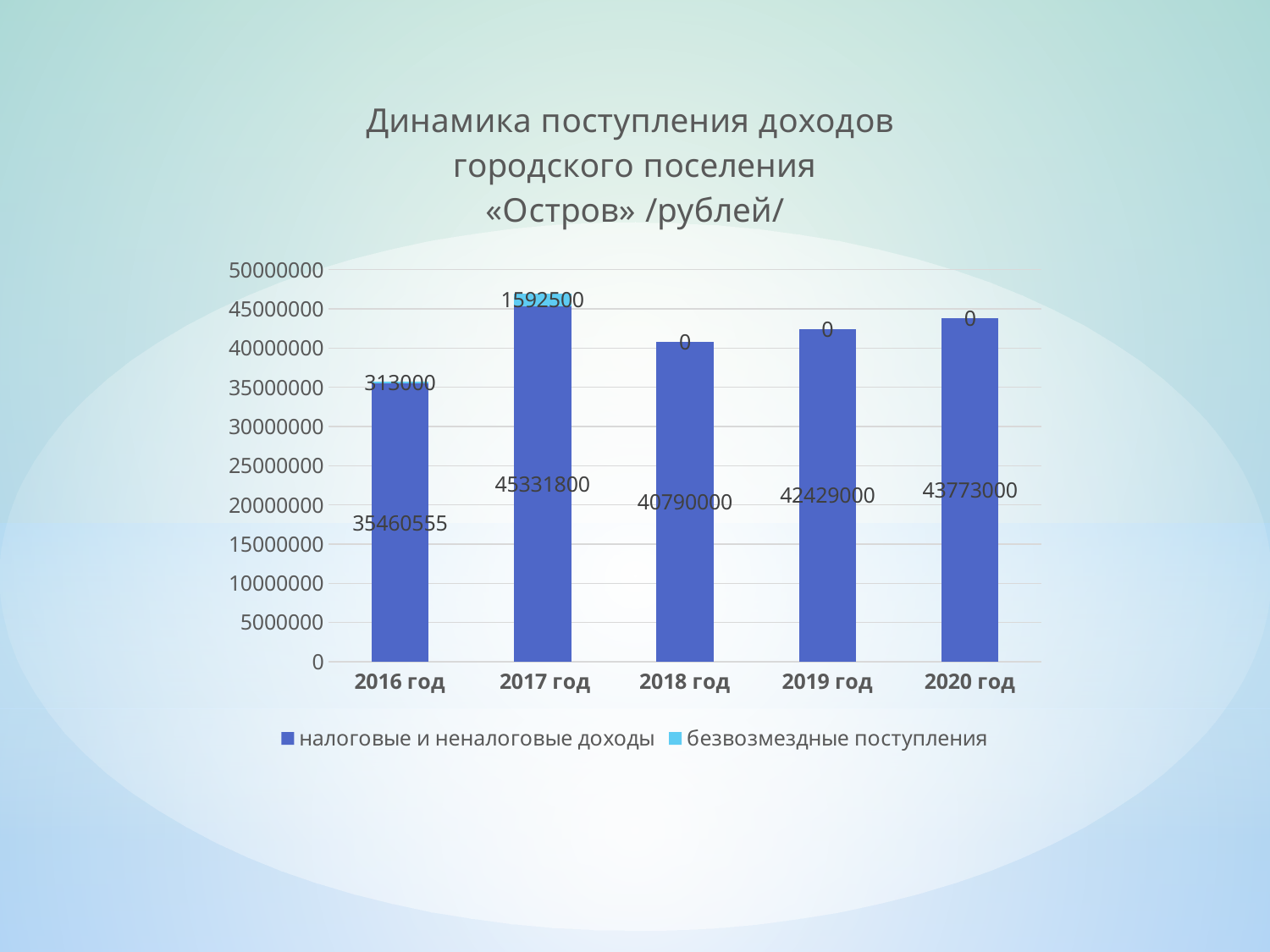
Which is larger: налоговые и неналоговые доходы in 2018 год or in 2019 год? 2019 год How many series does the legend list? 2 What is the value of налоговые и неналоговые доходы for 2016 год? 35460555 How many years are shown on the x axis? 5 What kind of chart is shown on the slide? Stacked bar chart What is the value of налоговые и неналоговые доходы for 2017 год? 45331800 Which year has the highest value of налоговые и неналоговые доходы? 2017 год What is the value of безвозмездные поступления for 2019 год? 0 Which year has the lowest value of налоговые и неналоговые доходы? 2016 год What is the total of the stacked bar for 2017 год? 46924300 What is the value of безвозмездные поступления for 2017 год? 1592500 What is the difference between налоговые и неналоговые доходы in 2020 год and 2019 год? 1344000